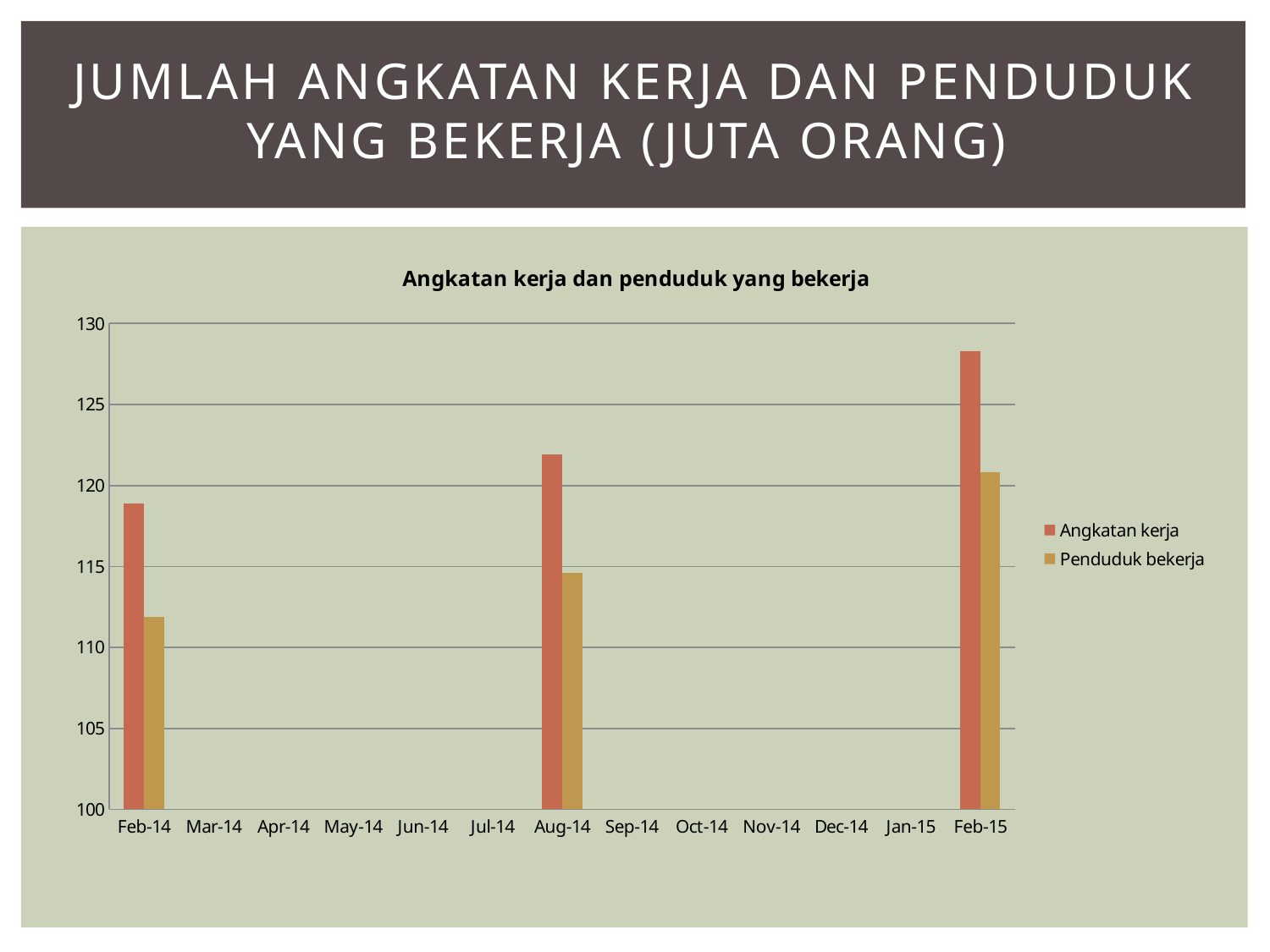
How many series does the legend list? 2 Do the Angkatan kerja values rise or fall from Feb-14 to Feb-15? rise How many months on the x axis have bars plotted? 3 Is the Penduduk bekerja value for Feb-14 greater or less than 115? less Which is larger in Feb-15, Angkatan kerja or Penduduk bekerja? Angkatan kerja Is the Angkatan kerja value for Feb-15 greater or less than 125? greater Which month has the lowest Penduduk bekerja value? Feb-14 Is the Angkatan kerja value for Aug-14 greater or less than 120? greater What kind of chart is shown on the slide? bar chart What is the title of the chart? Angkatan kerja dan penduduk yang bekerja Which month has the highest Angkatan kerja value? Feb-15